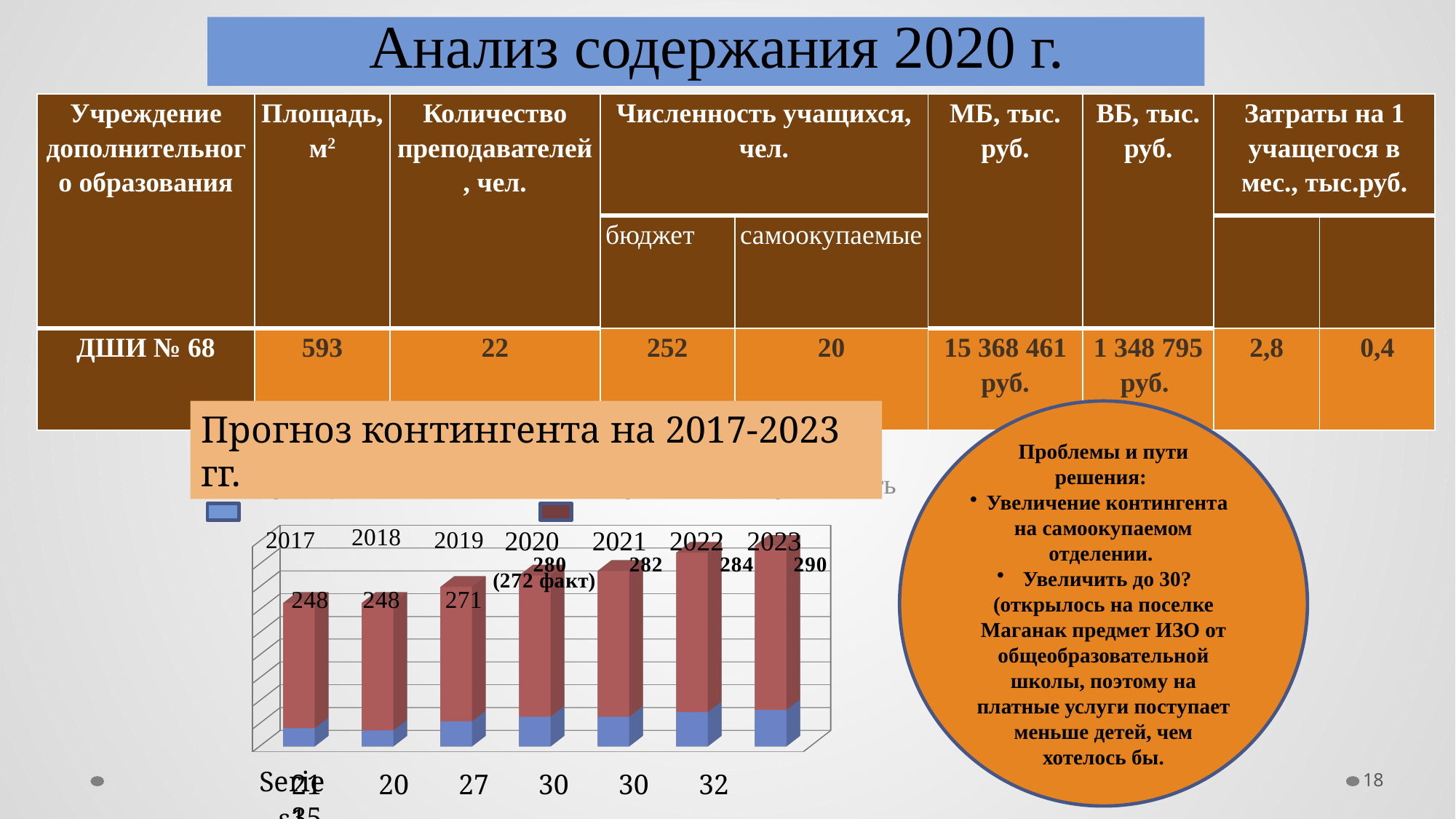
In the 'Прогноз контингента' chart, do the red-segment values rise or fall from 2017 to 2023? rise In the 'Прогноз контингента' chart, what value is labelled on the red segment for 2017? 248 In the 'Прогноз контингента' chart, what value is labelled on the red segment for 2023? 290 In the 'Прогноз контингента' chart, what actual ('факт') value is noted for 2020? 272 In the 'Прогноз контингента' chart, which year has the highest labelled red-segment value? 2023 In the 'Прогноз контингента' chart, which year has the larger red-segment value, 2019 or 2021? 2021 What is the title written above the bar chart on the slide? Прогноз контингента на 2017-2023 гг. How many series does the legend of the 'Прогноз контингента' chart show? 2 In the 'Прогноз контингента' chart, what is the difference between the red-segment values for 2023 and 2017? 42 How many years are plotted on the x axis of the 'Прогноз контингента' chart? 7 In the 'Прогноз контингента' chart, what value is labelled on the red segment for 2019? 271 What kind of chart is shown under the heading 'Прогноз контингента на 2017-2023 гг.'? bar chart